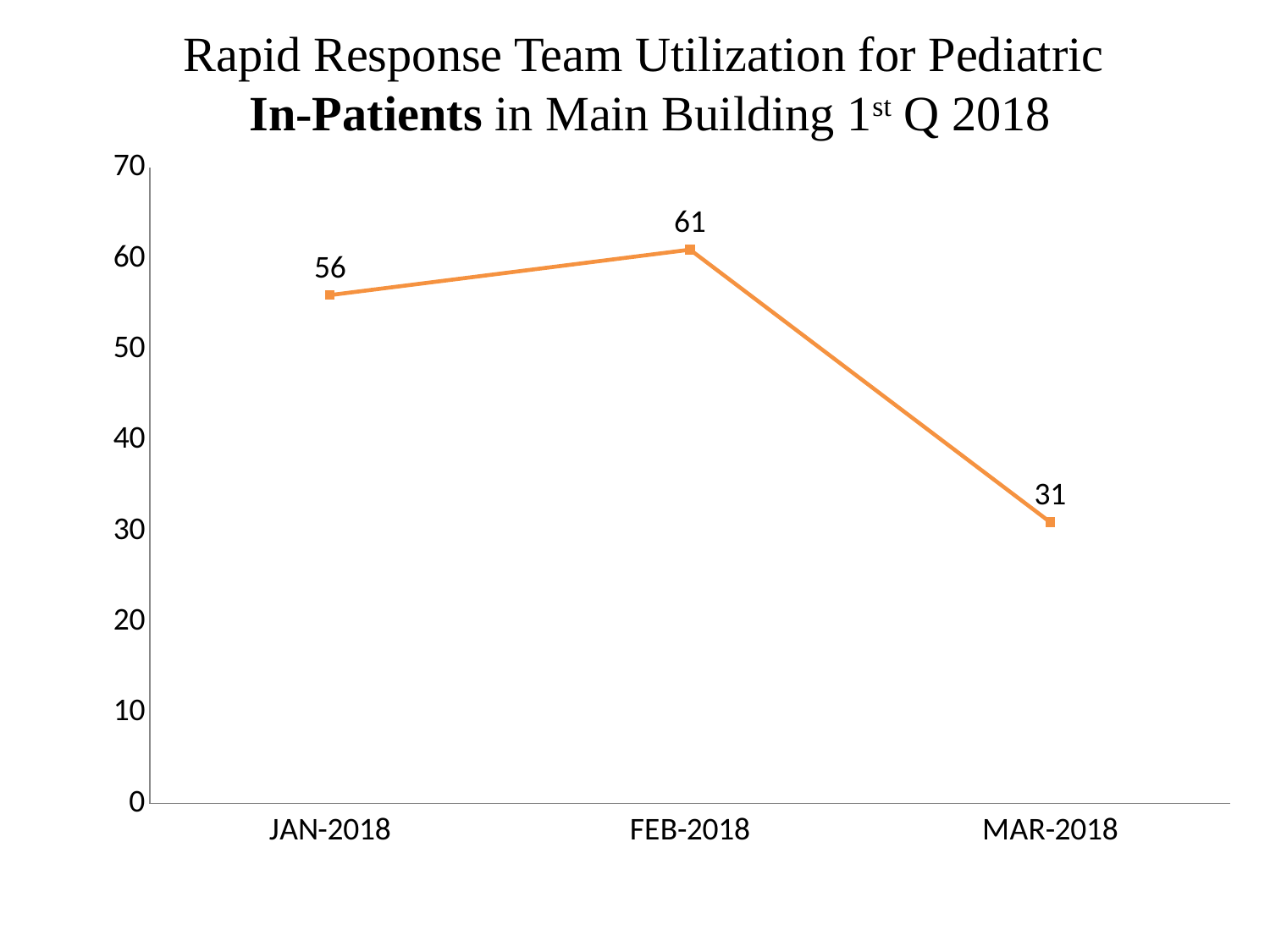
What is the difference between the values for FEB-2018 and JAN-2018? 5 Which month has the lowest value? MAR-2018 What is the difference between the values for FEB-2018 and MAR-2018? 30 How many data points are plotted on the chart? 3 Is the value for MAR-2018 greater or less than 40? less Does the value rise or fall from FEB-2018 to MAR-2018? fall Which is larger, the value for JAN-2018 or the value for MAR-2018? JAN-2018 What is the value for FEB-2018? 61 What is the value for MAR-2018? 31 Which month has the highest value? FEB-2018 What is the value for JAN-2018? 56 What kind of chart is shown on the slide? line chart